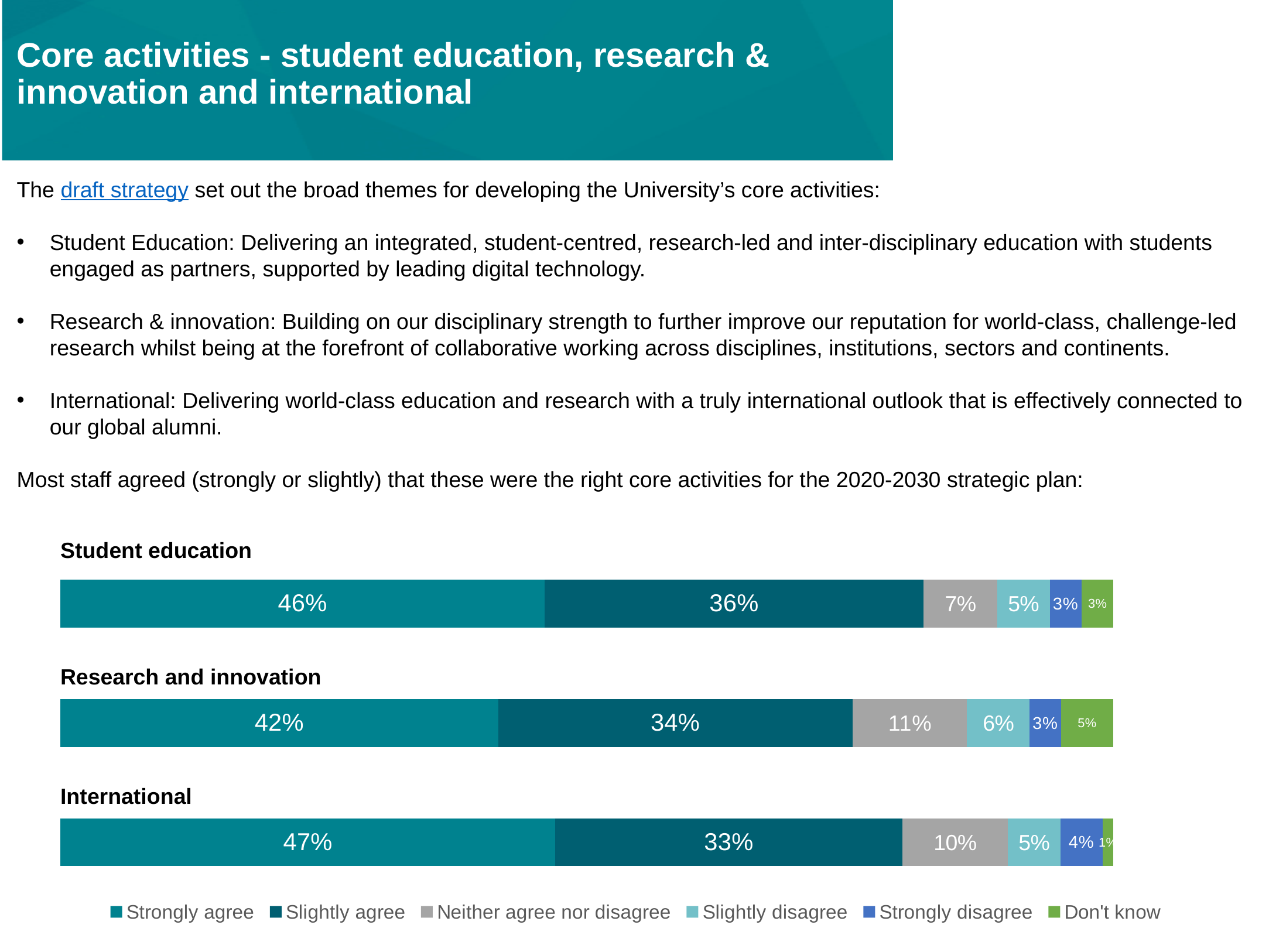
How many core activities are shown as bars on the slide? 3 What is the difference between the 'Strongly agree' percentages for International and Research and innovation? 5% What percentage of staff slightly agree with the Research and innovation core activity? 34% What is the combined percentage of staff who strongly or slightly agree with the Student education core activity? 82% How many response categories does the legend list? 6 What percentage of staff answered 'Don't know' for Research and innovation? 5% Which of the three core activities has the lowest 'Slightly agree' percentage? International Which of the three core activities has the highest 'Strongly agree' percentage? International What percentage of staff neither agree nor disagree with the International core activity? 10% Is the 'Neither agree nor disagree' percentage larger for Research and innovation or for Student education? Research and innovation What percentage of staff strongly agree with the Student education core activity? 46% What type of chart is used to show the staff responses? Stacked bar chart